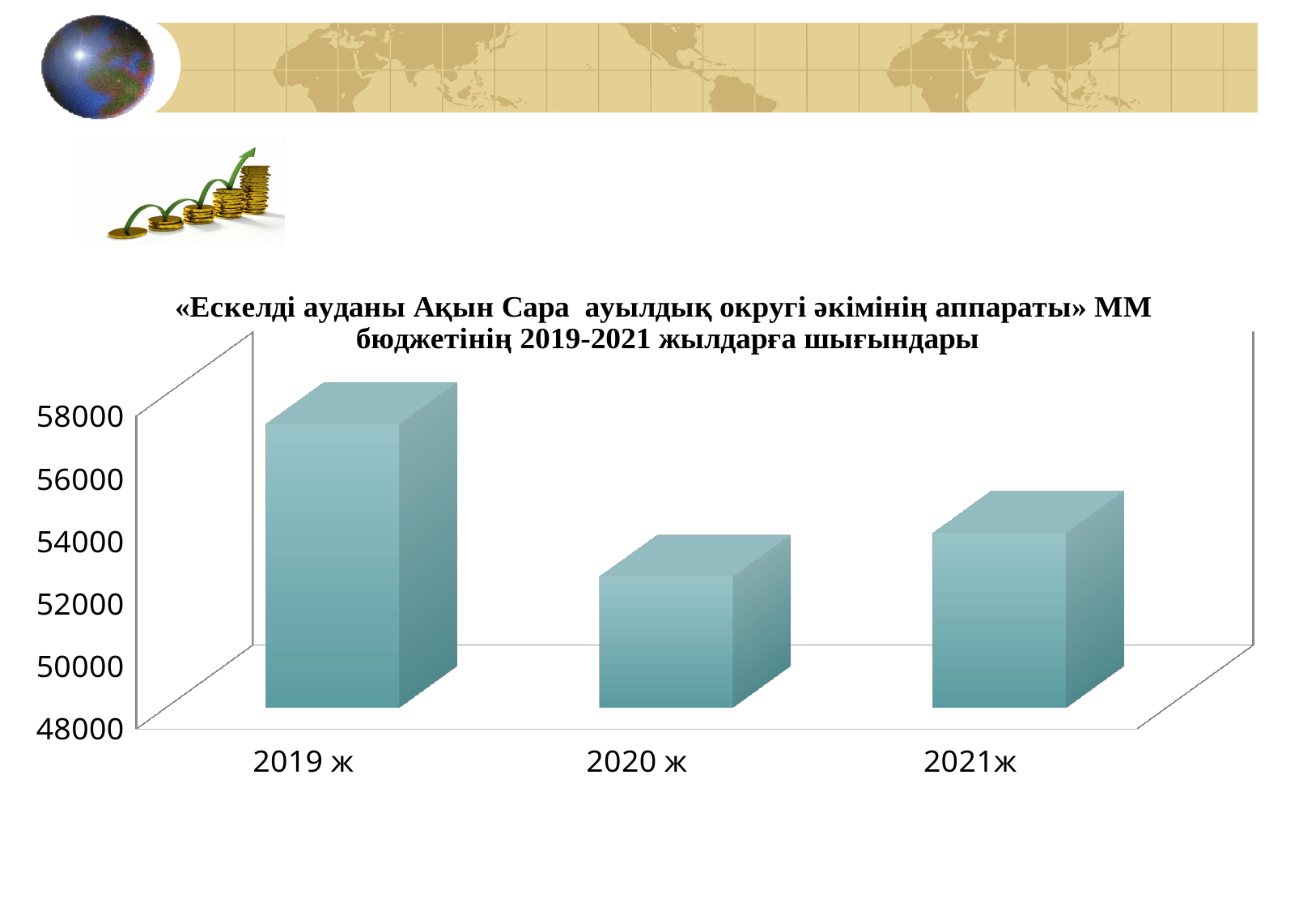
What kind of chart is shown on the slide? bar chart Which year has the lowest value in the chart? 2020 ж Which is larger, the value for 2019 ж or the value for 2021ж? 2019 ж Is the value for 2021ж greater or less than 56000? less What is the lowest value shown on the vertical axis of the chart? 48000 Which year has the highest value in the chart? 2019 ж Which is larger, the value for 2020 ж or the value for 2021ж? 2021ж How many categories (years) are shown on the x axis of the chart? 3 Is the value for 2020 ж greater or less than 54000? less Is the value for 2020 ж greater or less than 50000? greater Does the value rise or fall from 2019 ж to 2020 ж? fall